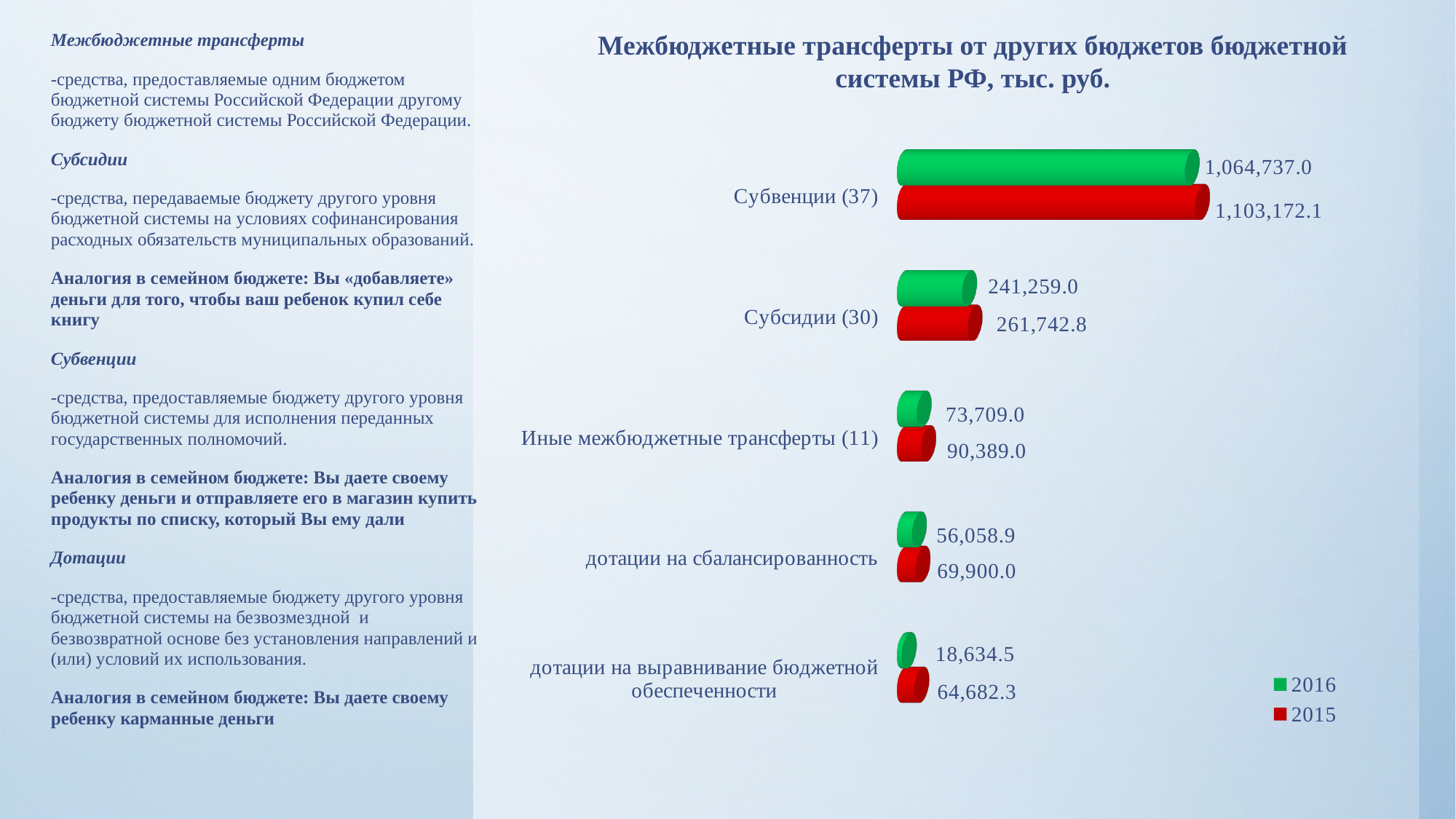
How many series does the legend list? 2 What is the 2015 value for Субсидии (30)? 261,742.8 Which category has the lowest 2016 value? дотации на выравнивание бюджетной обеспеченности What is the 2016 value for Субвенции (37)? 1,064,737.0 What kind of chart is shown on the slide? Bar chart Which category has the highest 2015 value? Субвенции (37) How many categories are shown in the chart? 5 What is the 2015 value for Иные межбюджетные трансферты (11)? 90,389.0 What is the difference between the 2015 and 2016 values for дотации на выравнивание бюджетной обеспеченности? 46,047.8 For дотации на сбалансированность, which year has the larger value, 2015 or 2016? 2015 What is the difference between the 2015 and 2016 values for Субсидии (30)? 20,483.8 What is the 2016 value for дотации на выравнивание бюджетной обеспеченности? 18,634.5